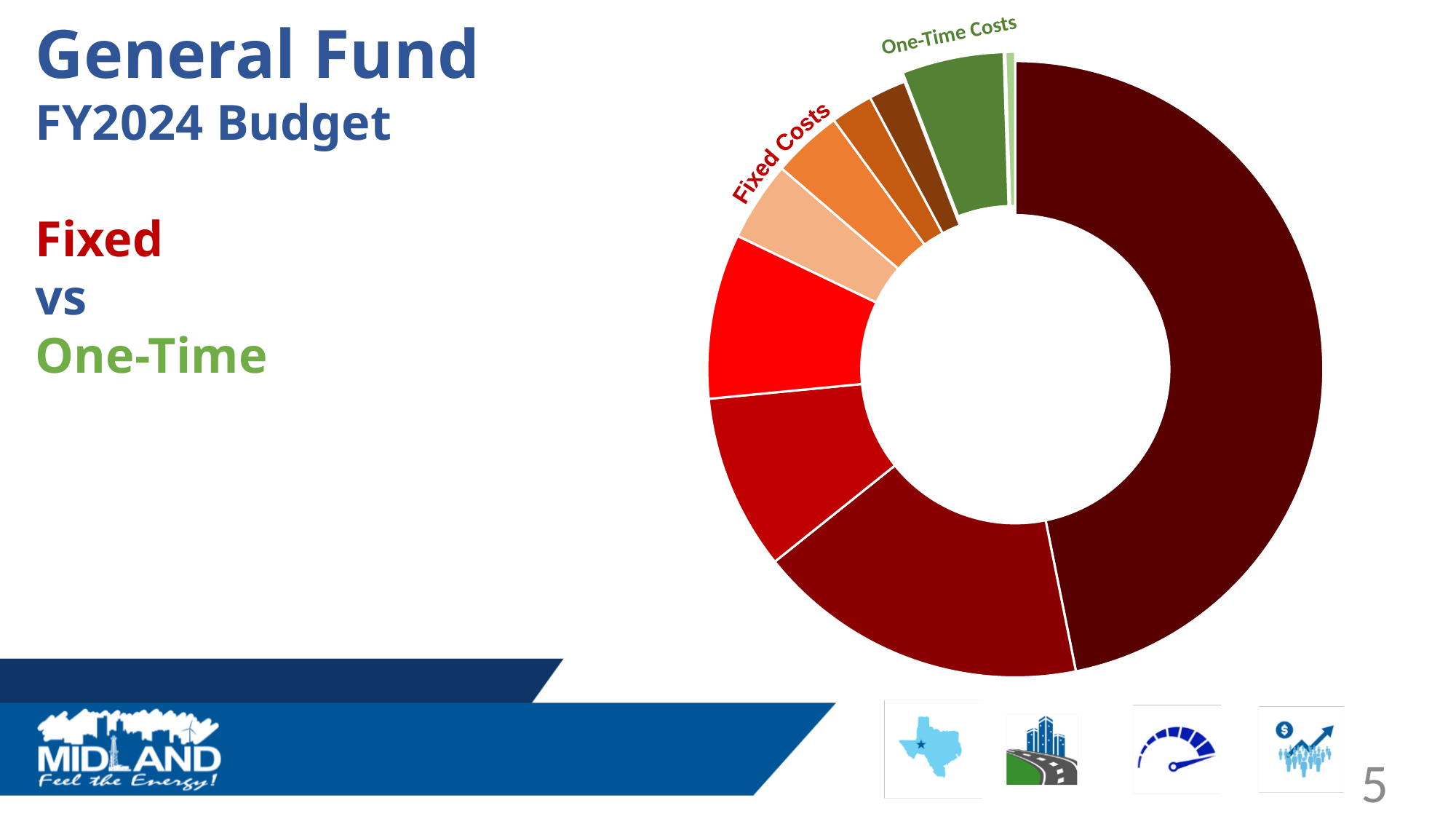
Is the share of the chart taken by Fixed Costs greater or less than 50%? greater Is the share of the chart taken by One-Time Costs greater or less than 25%? less Which single slice of the chart is the largest? the dark maroon Fixed Costs slice What is the title shown above the chart on the slide? General Fund FY2024 Budget Which is the smallest slice of the chart? the thin light green One-Time Costs slice Which group takes up the larger share of the chart, Fixed Costs or One-Time Costs? Fixed Costs What are the two cost groups labelled on the chart? Fixed Costs and One-Time Costs How many slices does the chart have? 10 What kind of chart is shown on the slide? pie chart (donut)